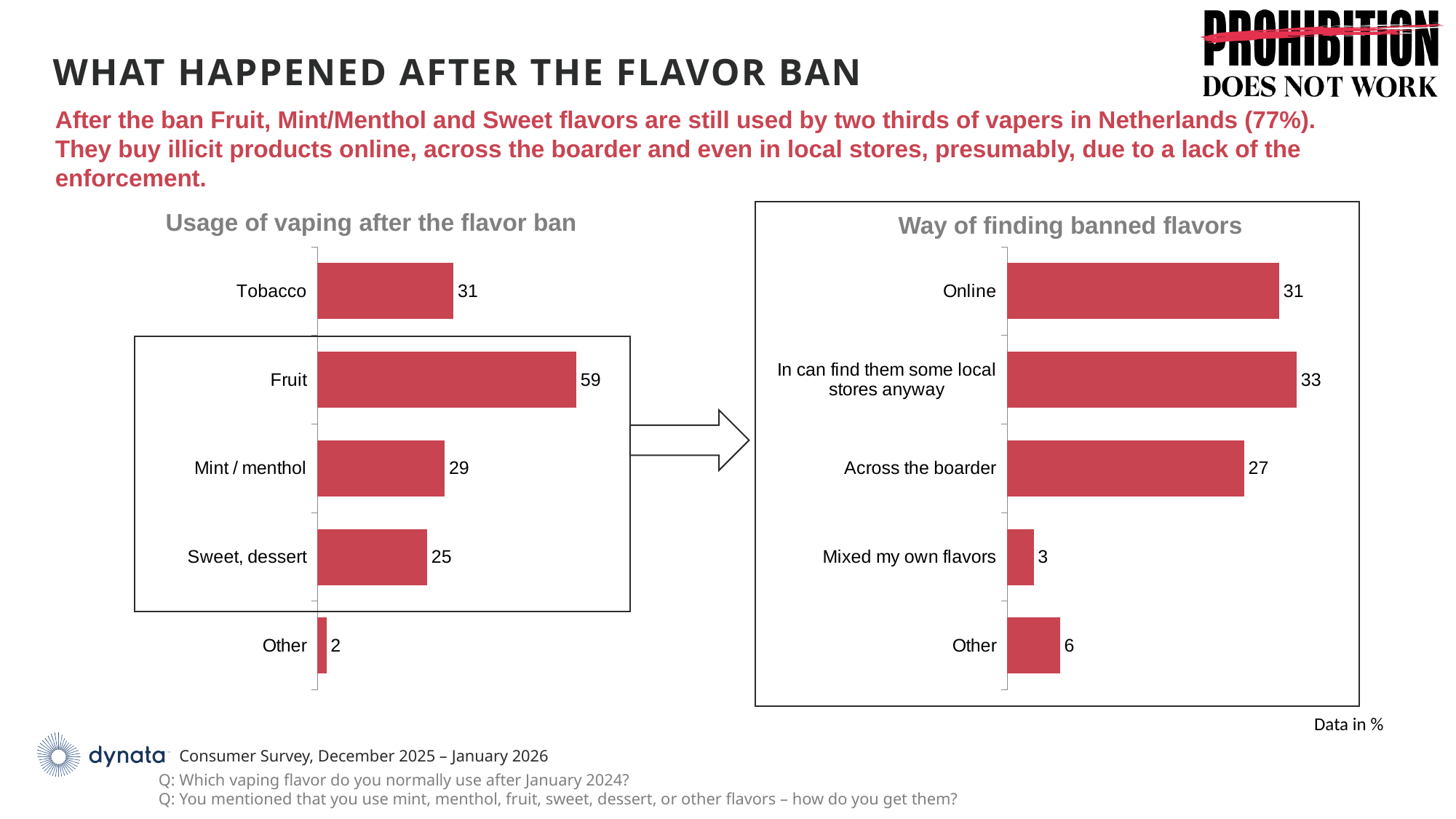
In the 'Usage of vaping after the flavor ban' chart, which category has the highest value? Fruit In the 'Way of finding banned flavors' chart, what is the value for Mixed my own flavors? 3 In the 'Usage of vaping after the flavor ban' chart, how many categories are shown? 5 What type of chart is the 'Way of finding banned flavors' chart? Bar chart In the 'Usage of vaping after the flavor ban' chart, what is the value for Mint / menthol? 29 In the 'Way of finding banned flavors' chart, which category has the highest value? In can find them some local stores anyway In the 'Usage of vaping after the flavor ban' chart, what is the value for Fruit? 59 In the 'Way of finding banned flavors' chart, what is the value for Across the boarder? 27 In the 'Usage of vaping after the flavor ban' chart, which category has the lowest value? Other In the 'Way of finding banned flavors' chart, which is larger: Online or Across the boarder? Online In the 'Usage of vaping after the flavor ban' chart, what is the difference between the values for Fruit and Tobacco? 28 In the 'Way of finding banned flavors' chart, what is the difference between the values for Online and Other? 25